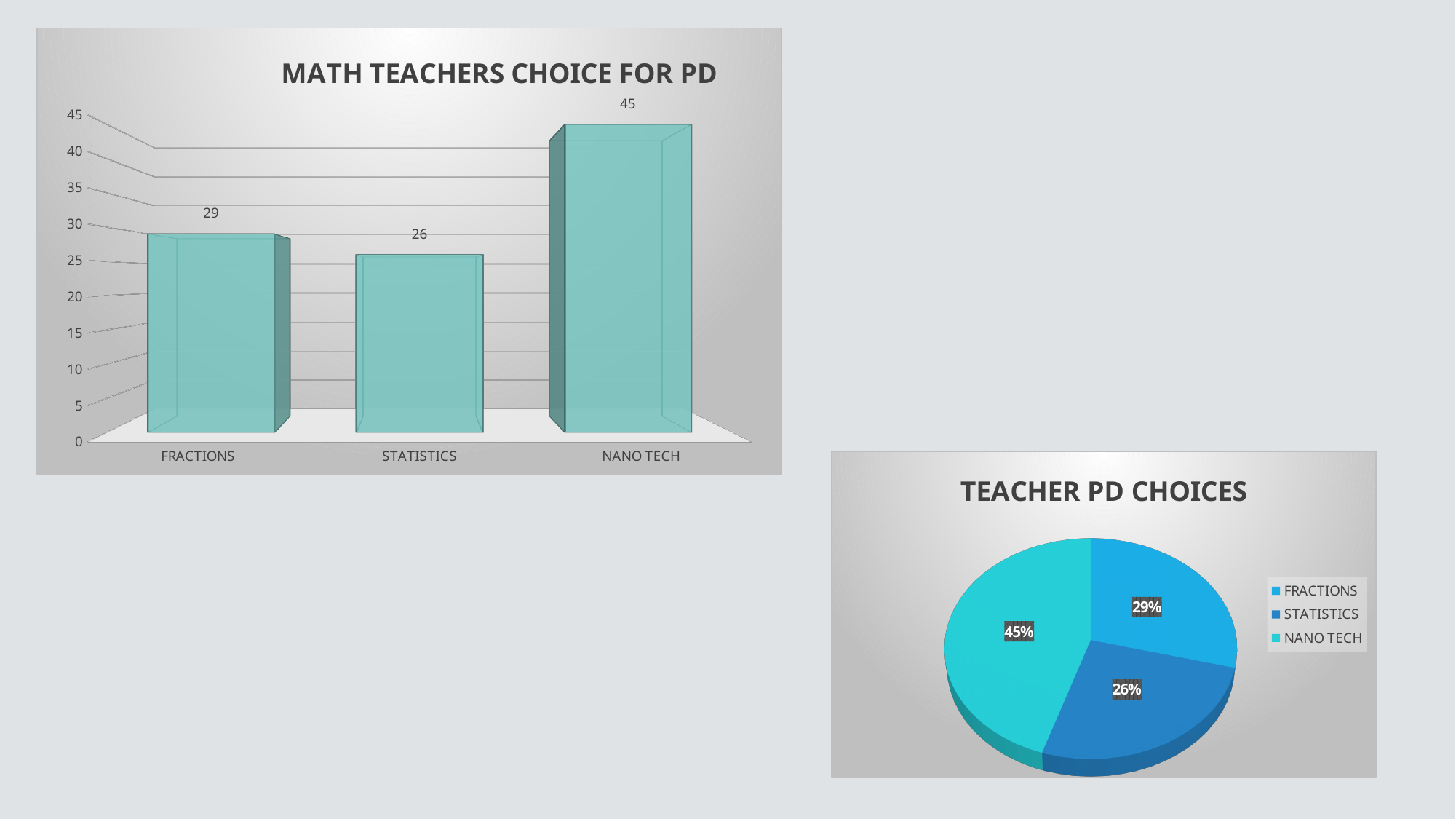
In the 'MATH TEACHERS CHOICE FOR PD' chart, which category has the highest value? NANO TECH In the 'MATH TEACHERS CHOICE FOR PD' chart, how many categories are shown? 3 In the 'MATH TEACHERS CHOICE FOR PD' chart, which category has the lowest value? STATISTICS In the 'TEACHER PD CHOICES' pie chart, what share does NANO TECH have? 45% In the 'MATH TEACHERS CHOICE FOR PD' chart, which is larger, FRACTIONS or STATISTICS? FRACTIONS In the 'MATH TEACHERS CHOICE FOR PD' chart, what is the value for NANO TECH? 45 How many entries does the legend of the 'TEACHER PD CHOICES' chart list? 3 In the 'TEACHER PD CHOICES' pie chart, what share does STATISTICS have? 26% In the 'MATH TEACHERS CHOICE FOR PD' chart, what is the difference between the values for NANO TECH and FRACTIONS? 16 In the 'MATH TEACHERS CHOICE FOR PD' chart, what is the value for STATISTICS? 26 What kind of chart is 'MATH TEACHERS CHOICE FOR PD'? Bar chart What kind of chart is 'TEACHER PD CHOICES'? Pie chart